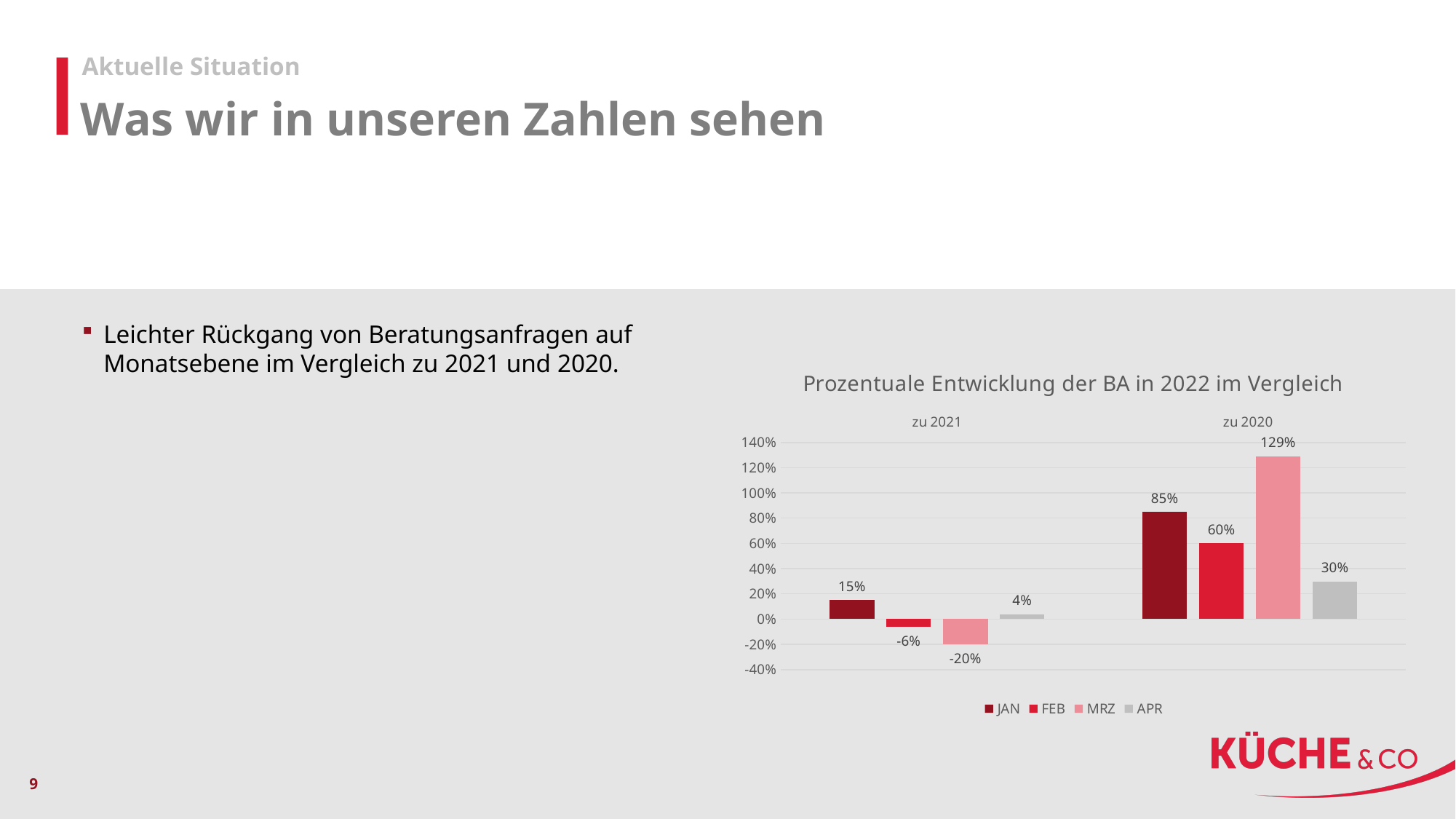
Which is larger: the APR value in the 'zu 2021' group or the APR value in the 'zu 2020' group? zu 2020 What is the value for MRZ in the 'zu 2020' group? 129% What is the title of the chart? Prozentuale Entwicklung der BA in 2022 im Vergleich How many category groups are shown on the x axis? 2 How many series does the legend list? 4 What is the value for FEB in the 'zu 2021' group? -6% What is the difference between the JAN and FEB values in the 'zu 2020' group? 25% Which month has the lowest value in the 'zu 2021' group? MRZ What is the value for APR in the 'zu 2020' group? 30% Which month has the highest value in the 'zu 2020' group? MRZ What kind of chart is shown on the slide? Bar chart What is the value for JAN in the 'zu 2021' group? 15%